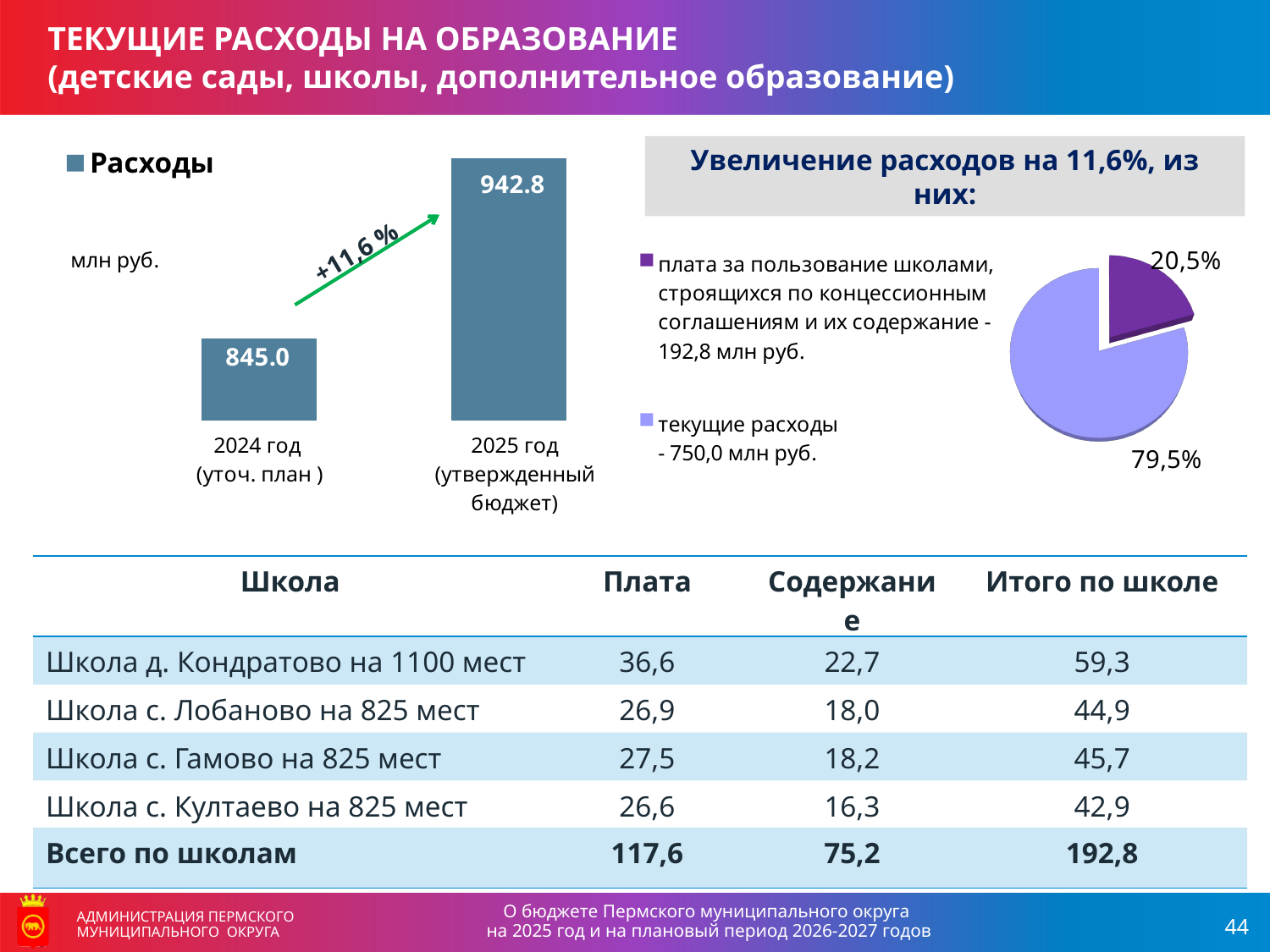
In the bar chart on the left, what is the value for 2024 год (уточ. план)? 845.0 In the bar chart on the left, which year has the higher value? 2025 год (утвержденный бюджет) In the bar chart on the left, which year has the lower value? 2024 год (уточ. план) In the bar chart on the left, do the values rise or fall from 2024 to 2025? rise In the bar chart on the left, what percentage change is shown by the arrow between the two bars? +11,6 % In the pie chart on the right, what share is shown for плата за пользование школами, строящихся по концессионным соглашениям и их содержание? 20,5% What type of chart is the chart on the right of the slide? pie chart In the bar chart on the left, what is the difference between the 2025 and 2024 values? 97.8 In the pie chart on the right, what share is shown for текущие расходы? 79,5% In the bar chart on the left, what is the value for 2025 год (утвержденный бюджет)? 942.8 What type of chart is the chart on the left titled Расходы? bar chart In the bar chart on the left, how many bars are plotted? 2